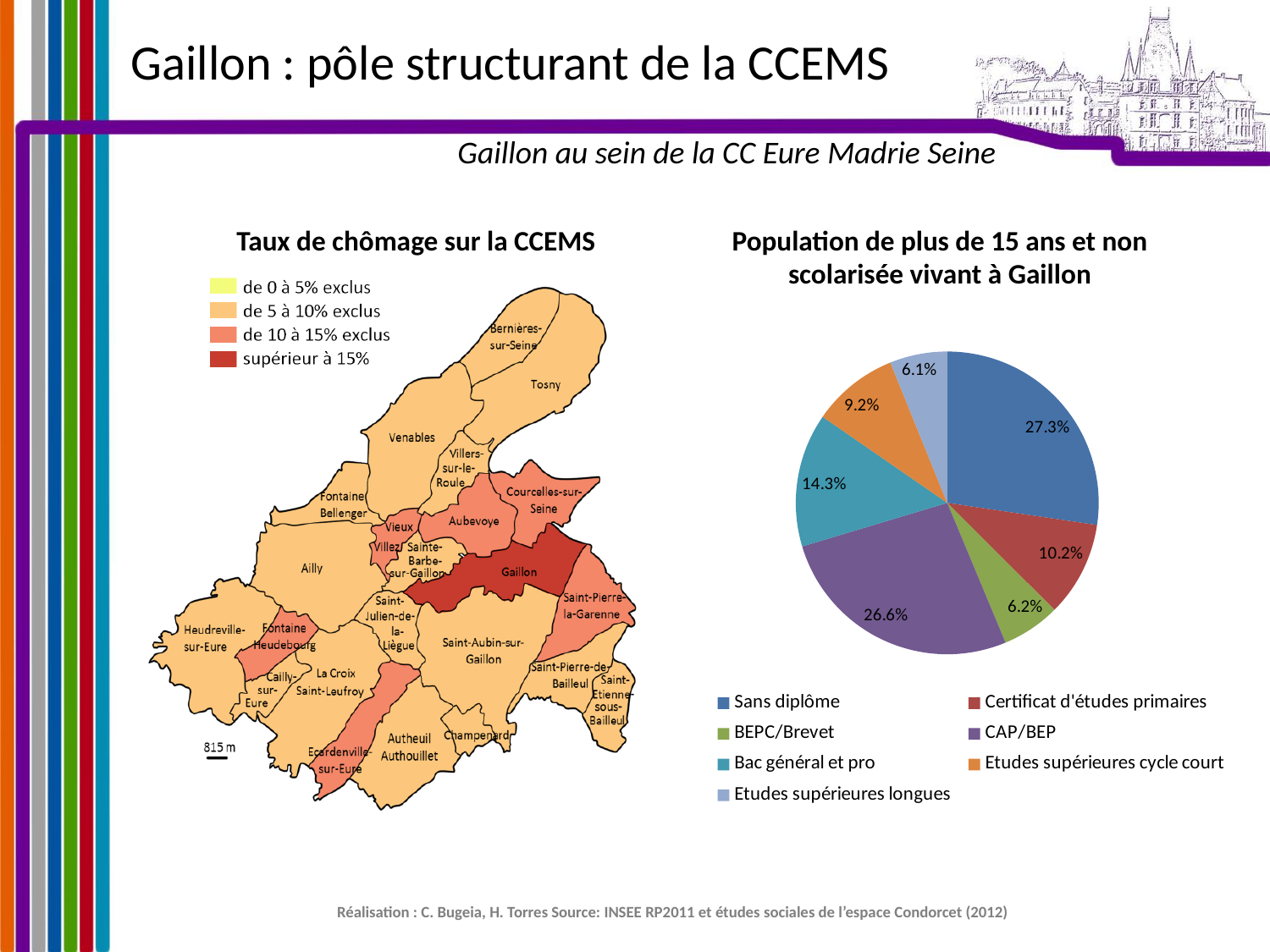
What kind of chart is 'Population de plus de 15 ans et non scolarisée vivant à Gaillon'? pie chart In the pie chart 'Population de plus de 15 ans et non scolarisée vivant à Gaillon', what share is 'Certificat d'études primaires'? 10.2% In the pie chart 'Population de plus de 15 ans et non scolarisée vivant à Gaillon', what share is 'Sans diplôme'? 27.3% How many entries does the legend of the pie chart 'Population de plus de 15 ans et non scolarisée vivant à Gaillon' list? 7 In the pie chart 'Population de plus de 15 ans et non scolarisée vivant à Gaillon', which is larger: 'Bac général et pro' or 'Etudes supérieures cycle court'? Bac général et pro In the pie chart 'Population de plus de 15 ans et non scolarisée vivant à Gaillon', what colour is the 'CAP/BEP' slice? purple In the pie chart 'Population de plus de 15 ans et non scolarisée vivant à Gaillon', what is the difference between 'Sans diplôme' and 'Certificat d'études primaires'? 17.1 percentage points In the pie chart 'Population de plus de 15 ans et non scolarisée vivant à Gaillon', what share is 'CAP/BEP'? 26.6% In the pie chart 'Population de plus de 15 ans et non scolarisée vivant à Gaillon', what share is 'Bac général et pro'? 14.3% In the pie chart 'Population de plus de 15 ans et non scolarisée vivant à Gaillon', which category has the largest share? Sans diplôme In the pie chart 'Population de plus de 15 ans et non scolarisée vivant à Gaillon', how many slices are there? 7 In the pie chart 'Population de plus de 15 ans et non scolarisée vivant à Gaillon', what share is 'Etudes supérieures longues'? 6.1%